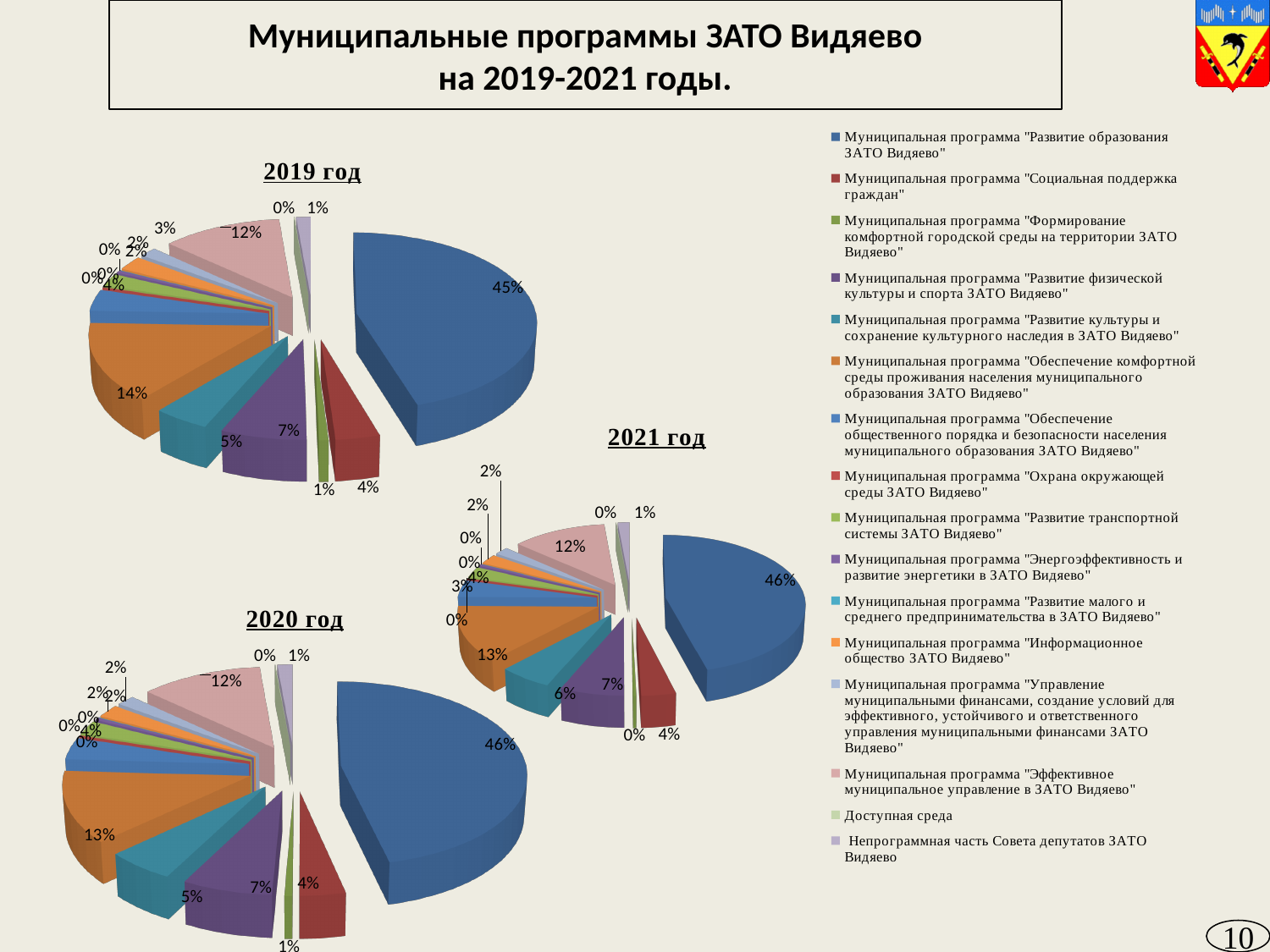
In the 2019 год chart, what share does the largest slice have? 45% In the 2020 год chart, which is larger: the share for "Развитие физической культуры и спорта ЗАТО Видяево" (7%) or the share for "Социальная поддержка граждан" (4%)? Развитие физической культуры и спорта ЗАТО Видяево In the 2021 год chart, what share does the largest slice have? 46% What is the title of the slide? Муниципальные программы ЗАТО Видяево на 2019-2021 годы. In the 2019 год chart, what is the difference in percentage points between the 45% slice and the 14% slice? 31 percentage points In the 2021 год chart, what share is shown for the programme "Эффективное муниципальное управление в ЗАТО Видяево"? 12% In the 2020 год chart, what share does the largest slice have? 46% In the 2019 год chart, what share is shown for the programme "Обеспечение комфортной среды проживания населения муниципального образования ЗАТО Видяево"? 14% What kind of charts are shown on the slide? Pie charts How many pie charts are on the slide? 3 In the 2019 год chart, what share is shown for the programme "Развитие образования ЗАТО Видяево"? 45% How many entries does the legend list? 16